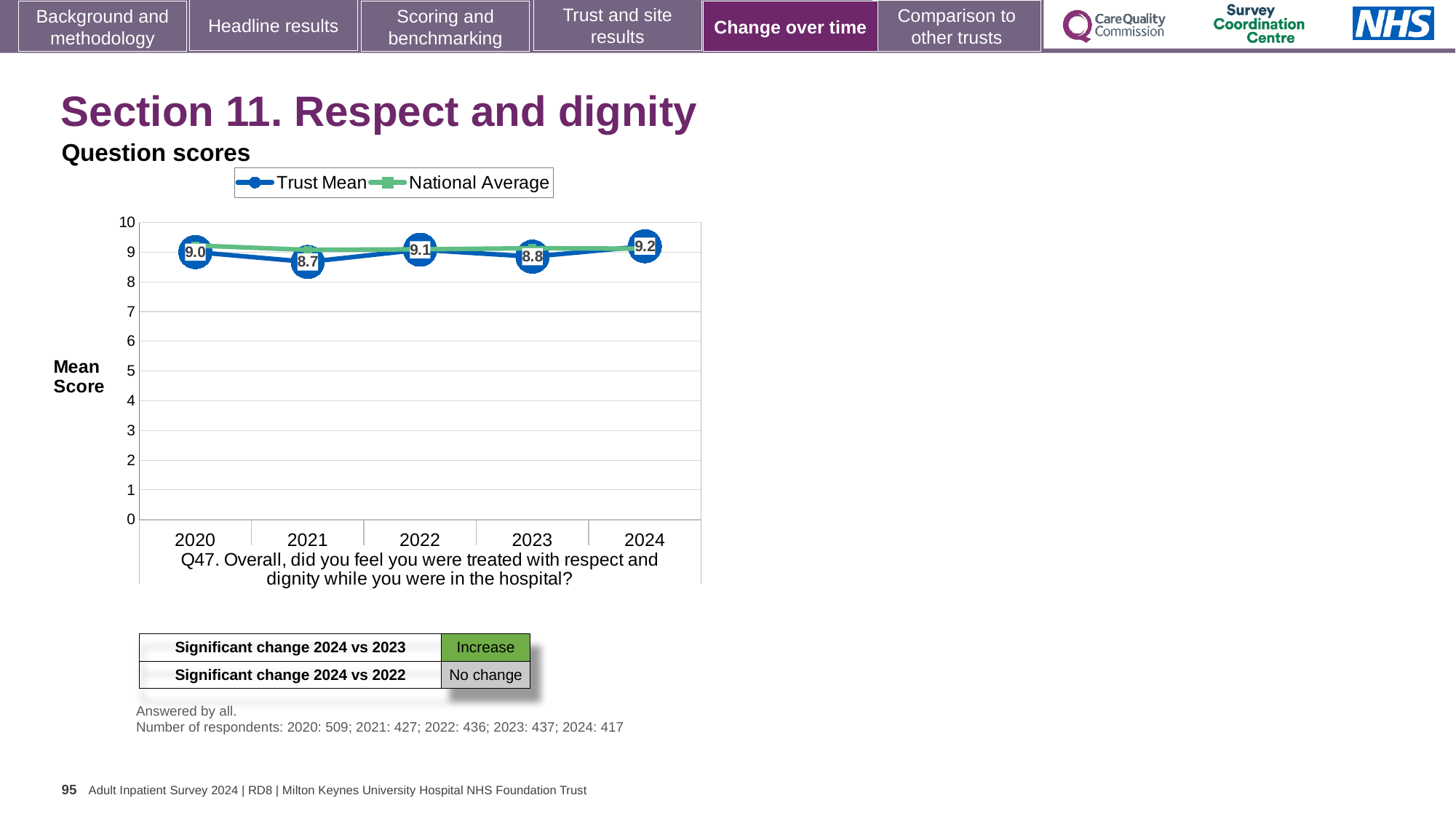
What is the Trust Mean score for 2022? 9.1 Does the Trust Mean score rise or fall from 2023 to 2024? rise How many series does the legend list? 2 Is the National Average value for 2021 greater or less than 8? greater Which year has the larger Trust Mean score, 2021 or 2022? 2022 What is the difference between the Trust Mean scores for 2024 and 2023? 0.4 In which year is the Trust Mean score lowest? 2021 What is the Trust Mean score for 2024? 9.2 How many years are plotted on the x axis? 5 What is the Trust Mean score for 2021? 8.7 In which year is the Trust Mean score highest? 2024 What kind of chart is shown? line chart